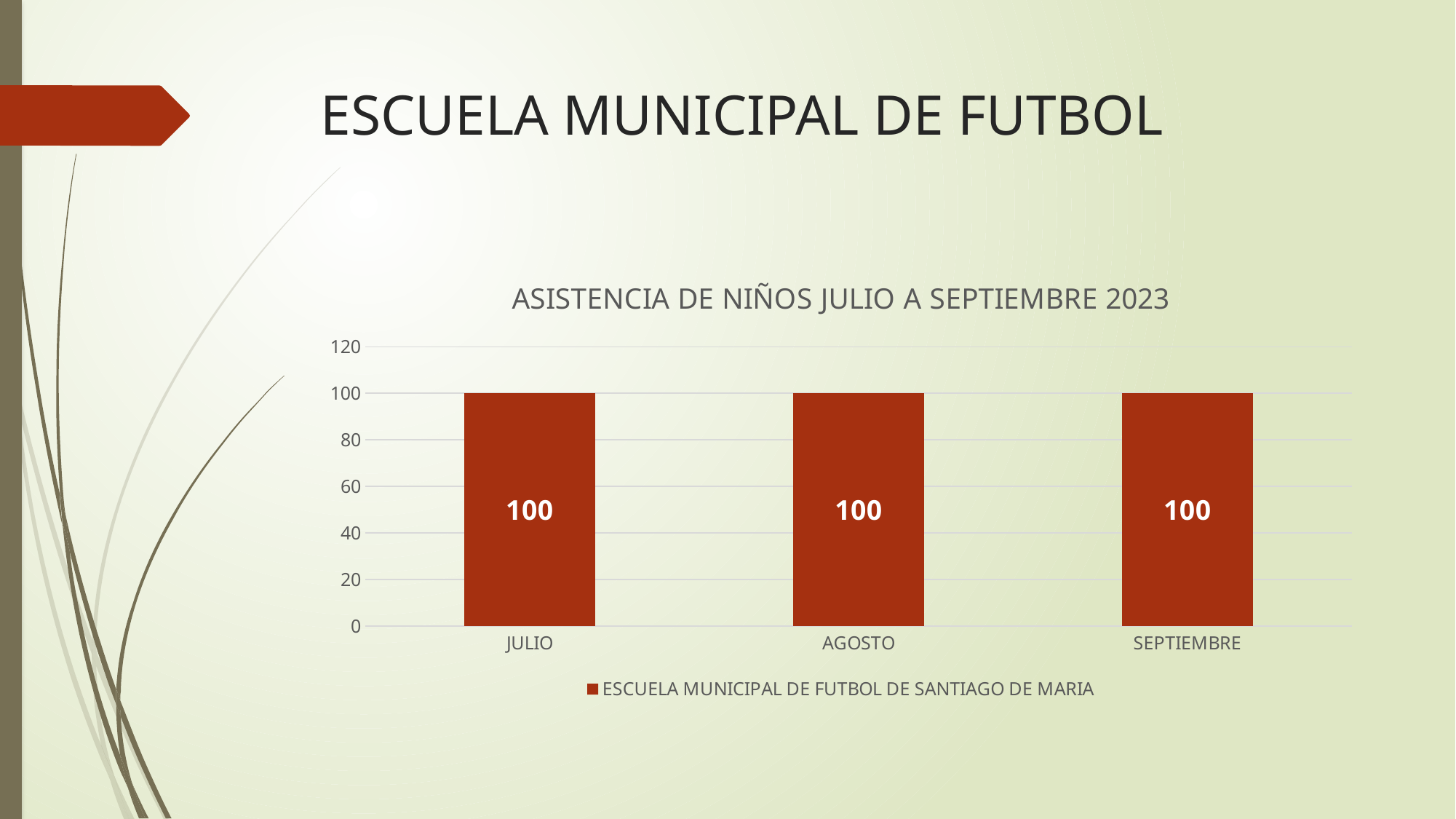
How many series does the legend list? 1 Is the value for SEPTIEMBRE greater or less than 120? less How many categories are shown on the x axis? 3 What is the value for SEPTIEMBRE? 100 What is the difference between the values for JULIO and SEPTIEMBRE? 0 What is the value for AGOSTO? 100 Is the value for AGOSTO greater or less than 80? greater Do the values rise, fall, or stay the same from JULIO to SEPTIEMBRE? stay the same What is the value for JULIO? 100 What is the title of the chart? ASISTENCIA DE NIÑOS JULIO A SEPTIEMBRE 2023 What series name does the legend show? ESCUELA MUNICIPAL DE FUTBOL DE SANTIAGO DE MARIA What kind of chart is shown? bar chart